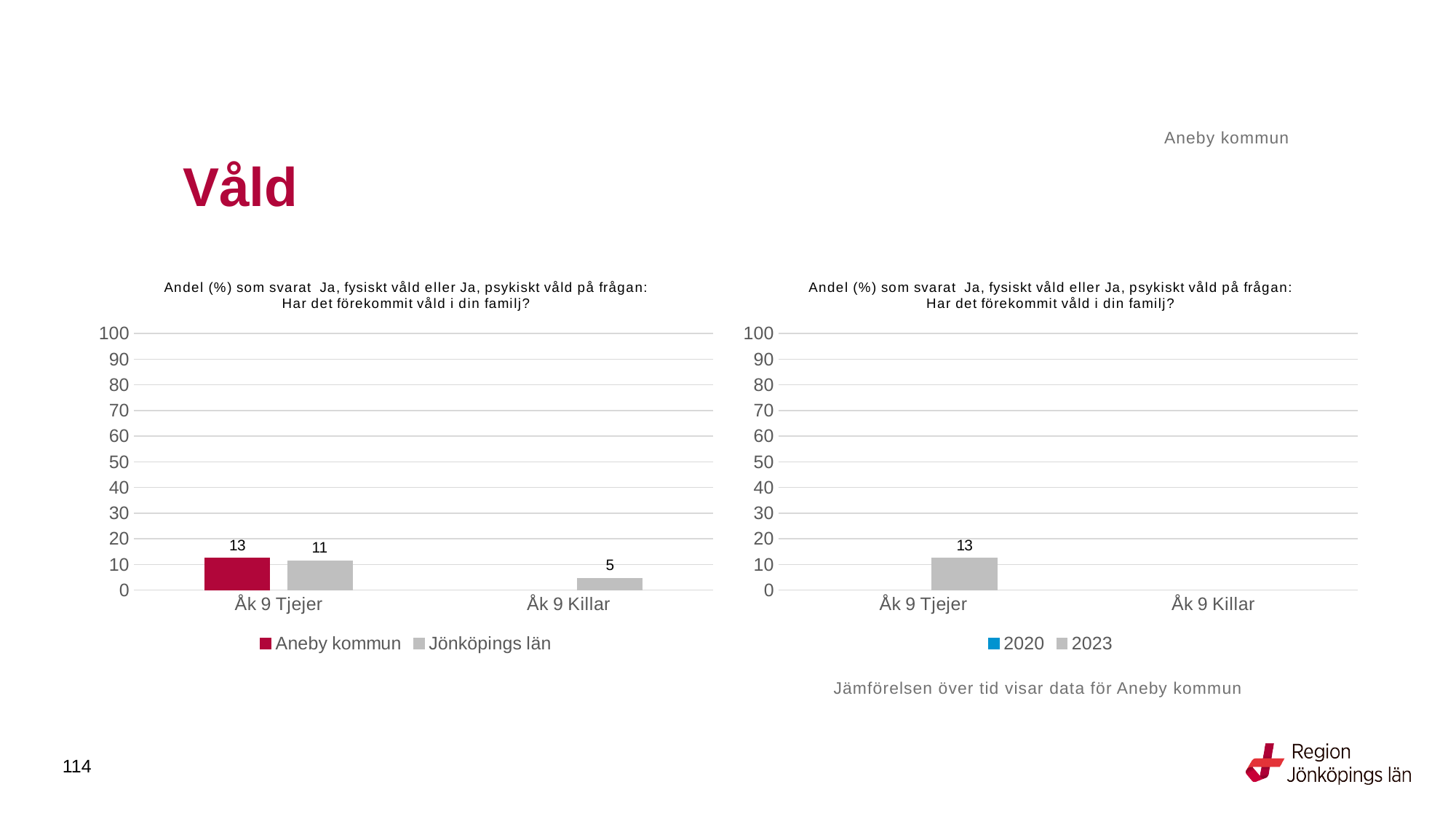
In the left chart, what is the value for Jönköpings län for Åk 9 Killar? 5 In the left chart, what is the value for Aneby kommun for Åk 9 Tjejer? 13 What kind of chart is the right chart? bar chart How many categories are shown on the x axis of the right chart? 2 In the left chart, is the Jönköpings län value for Åk 9 Killar greater or less than 10? less In the left chart, what is the difference between the Aneby kommun and Jönköpings län values for Åk 9 Tjejer? 2 What series does the legend of the right chart list? 2020 and 2023 In the right chart, what is the value for 2023 for Åk 9 Tjejer? 13 In the left chart, which is larger for Åk 9 Tjejer: Aneby kommun or Jönköpings län? Aneby kommun In the left chart, which category has the lowest Jönköpings län value? Åk 9 Killar In the left chart, what is the value for Jönköpings län for Åk 9 Tjejer? 11 How many series does the legend of the left chart list? 2